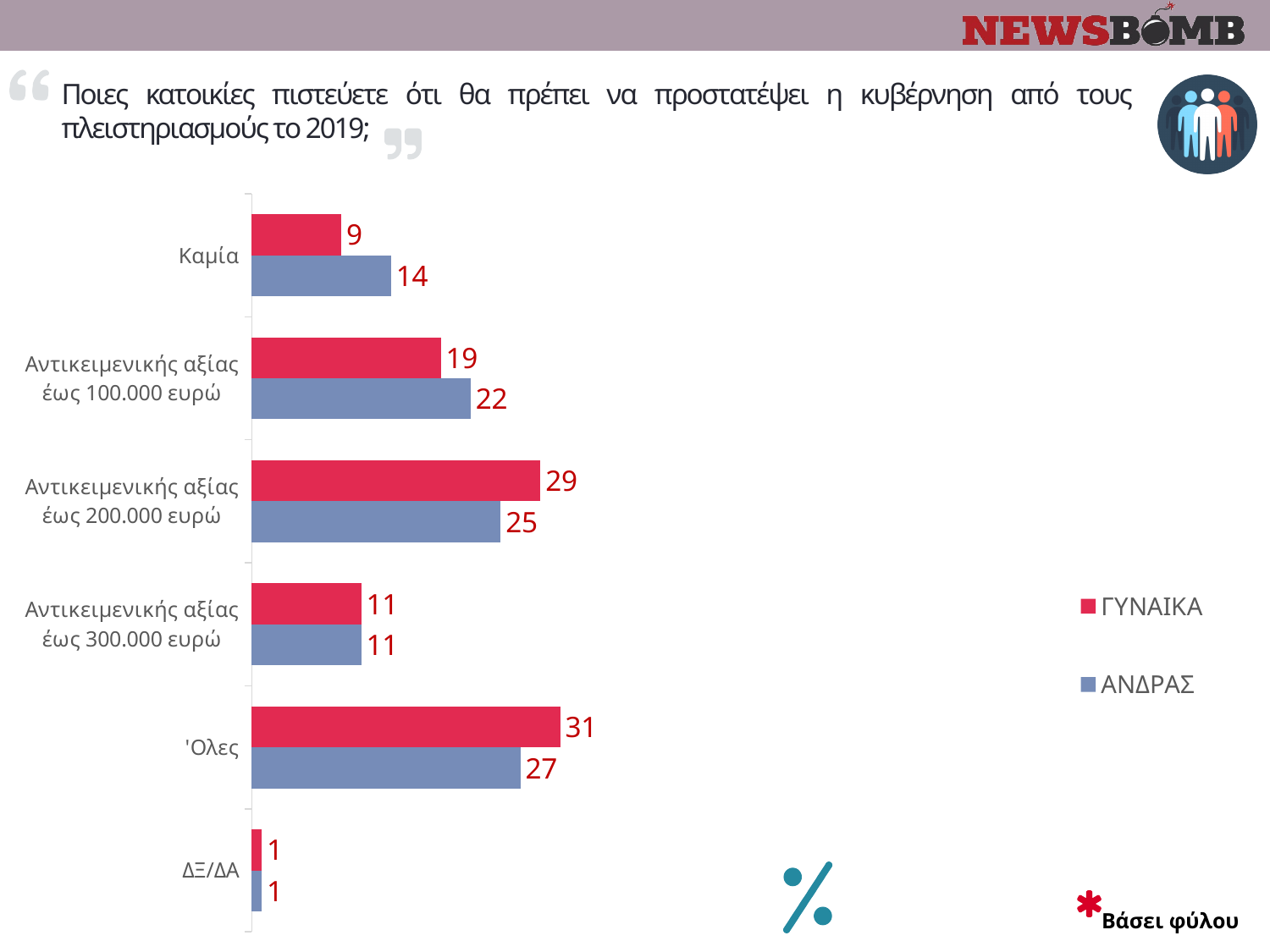
In the category 'Καμία', which series has the larger value, ΓΥΝΑΙΚΑ or ΑΝΔΡΑΣ? ΑΝΔΡΑΣ What is the difference between the ΓΥΝΑΙΚΑ and ΑΝΔΡΑΣ values in the category 'Αντικειμενικής αξίας έως 200.000 ευρώ'? 4 How many categories are shown on the chart? 6 Which colour represents the ΑΝΔΡΑΣ series in the legend? Blue What kind of chart is shown on the slide? Bar chart Which category has the highest value for ΓΥΝΑΙΚΑ? Όλες What is the value for ΓΥΝΑΙΚΑ in the category 'Όλες'? 31 What is the value for ΑΝΔΡΑΣ in the category 'Καμία'? 14 How many series does the legend list? 2 What is the value for ΑΝΔΡΑΣ in the category 'Αντικειμενικής αξίας έως 100.000 ευρώ'? 22 Which category has the lowest value for ΑΝΔΡΑΣ? ΔΞ/ΔΑ What is the value for ΓΥΝΑΙΚΑ in the category 'Αντικειμενικής αξίας έως 300.000 ευρώ'? 11